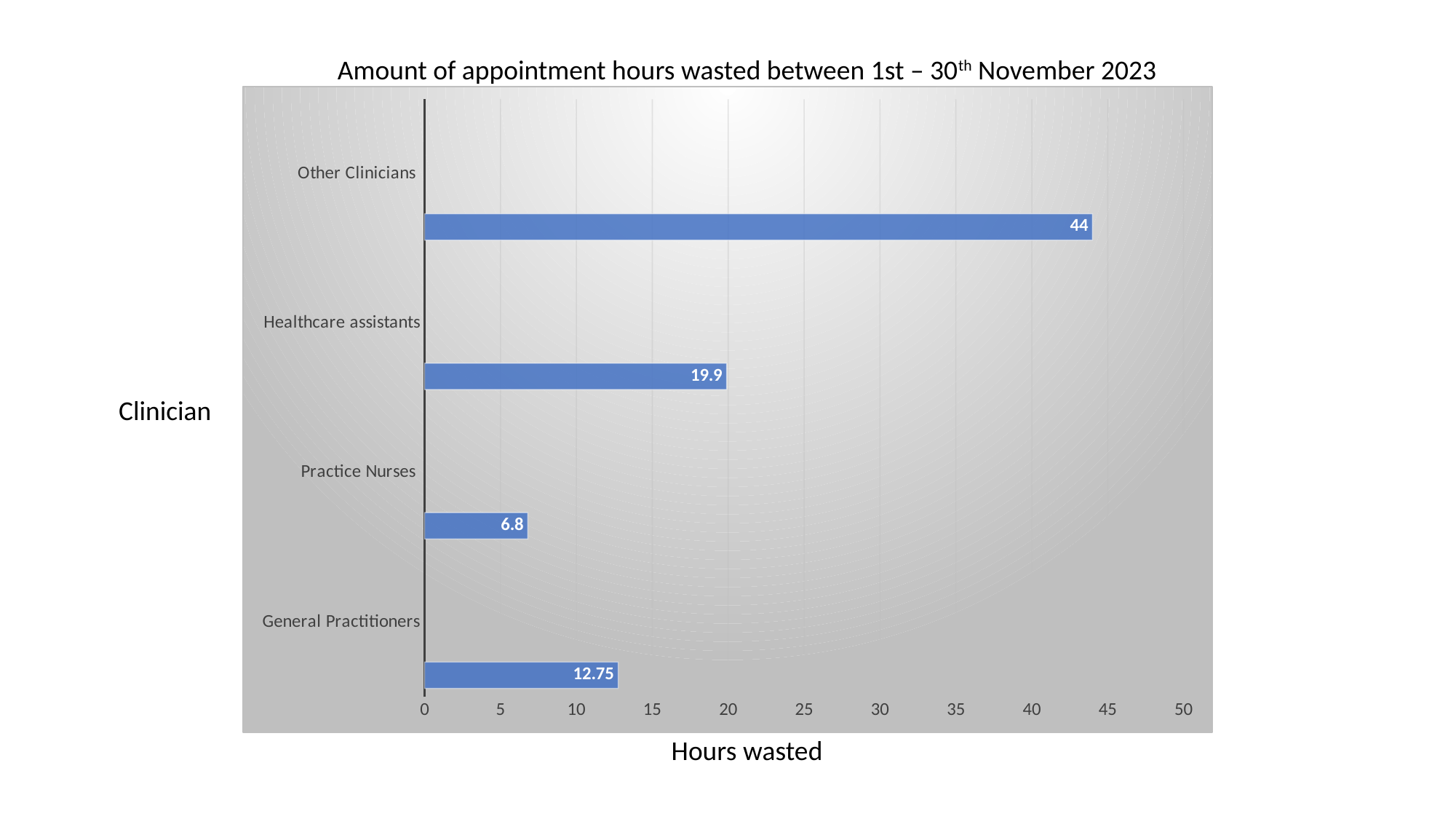
How many hours were wasted by Other Clinicians? 44 How many hours were wasted by General Practitioners? 12.75 Which wasted more hours, Healthcare assistants or General Practitioners? Healthcare assistants What type of chart is shown on the slide? Bar chart What is the difference in hours wasted between Other Clinicians and Healthcare assistants? 24.1 What is the difference in hours wasted between General Practitioners and Practice Nurses? 5.95 How many hours were wasted by Practice Nurses? 6.8 How many clinician groups are shown in the chart? 4 Which clinician group wasted the fewest appointment hours? Practice Nurses What is the label of the horizontal axis? Hours wasted Which clinician group wasted the most appointment hours? Other Clinicians How many hours were wasted by Healthcare assistants? 19.9